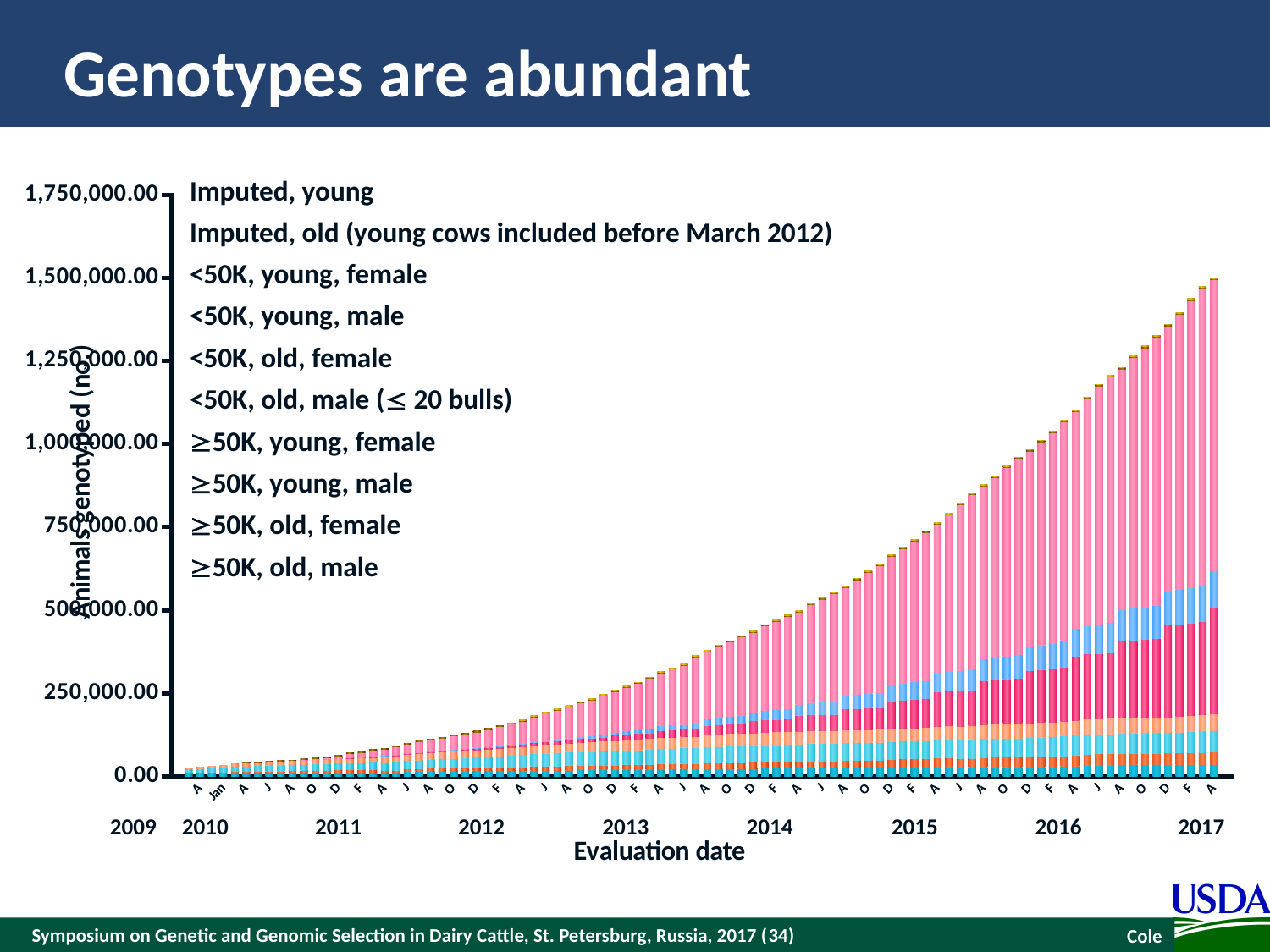
What kind of chart is shown on the slide? stacked bar chart Which year on the x axis has the shortest bars? 2009 Do the total numbers of animals genotyped rise or fall from 2009 to 2017? rise How many series does the legend list? 10 What is the label of the y axis? Animals genotyped (no.) Which year on the x axis has the tallest bar? 2017 Is the total for the bar at the start of 2015 greater or less than 500,000.00? greater Is the total for the last bar (2017) greater or less than 1,250,000.00? greater Which is larger, the total bar at the start of 2016 or the total bar at the start of 2014? 2016 Is the total for the bar at the start of 2014 greater or less than 500,000.00? less What is the label of the x axis? Evaluation date